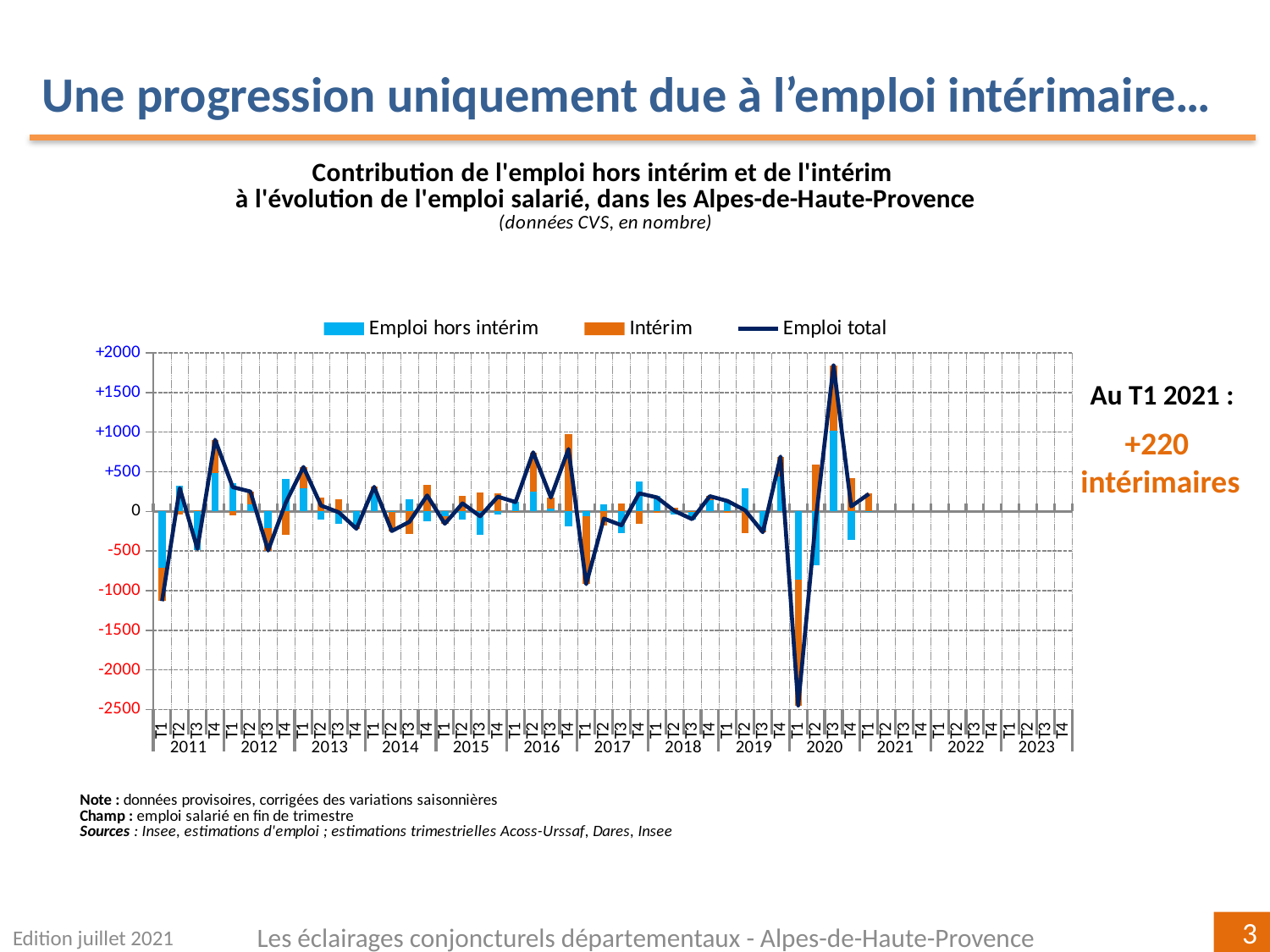
Is the Emploi total value for T3 2020 greater or less than +1500? greater In which quarter does the Emploi total line reach its highest value? T3 2020 According to the annotation on the slide, what is the number of intérimaires at T1 2021? +220 What are the three series named in the chart legend? Emploi hors intérim, Intérim, Emploi total Is the Emploi total value for T4 2011 greater or less than +500? greater Is the Emploi total value for T1 2020 greater or less than -2000? less Which series is drawn as a line rather than bars? Emploi total What kind of chart is shown on the slide? A combined bar and line chart Which is larger, the Emploi total value for T3 2020 or for T4 2011? T3 2020 In which quarter does the Emploi total line reach its lowest value? T1 2020 How many series does the chart legend list? 3